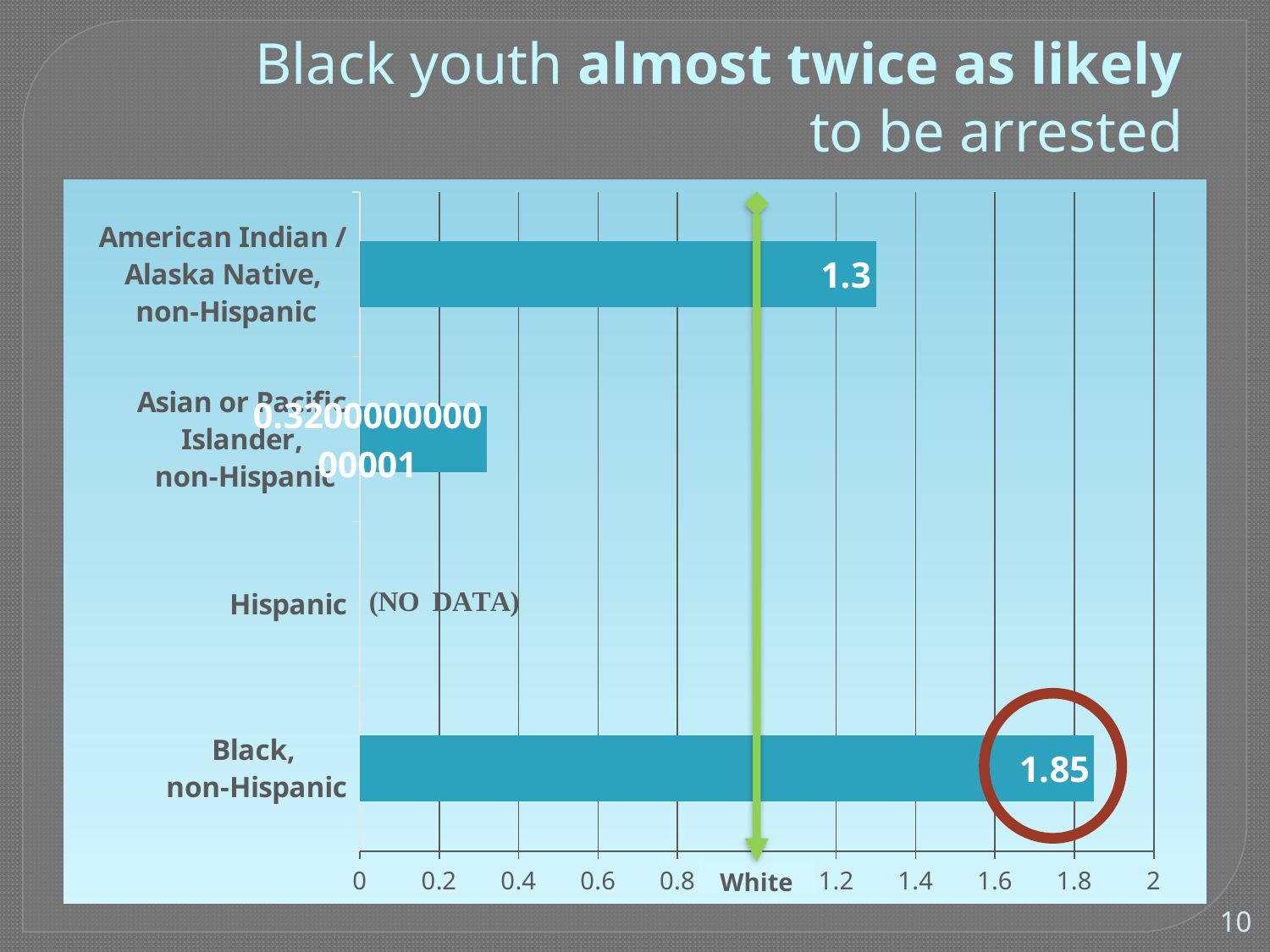
What is the value for American Indian / Alaska Native, non-Hispanic? 1.3 Is the value for American Indian / Alaska Native, non-Hispanic greater or less than 1.2? greater What kind of chart is shown on the slide? bar chart Which category with a plotted bar has the lowest value? Asian or Pacific Islander, non-Hispanic Which category has the highest value? Black, non-Hispanic Is the value for Asian or Pacific Islander, non-Hispanic greater or less than 0.4? less What is the value for Black, non-Hispanic? 1.85 What label is given to the green vertical reference line on the chart? White What is the difference between the values for Black, non-Hispanic and American Indian / Alaska Native, non-Hispanic? 0.55 Which is larger, the value for Black, non-Hispanic or the value for American Indian / Alaska Native, non-Hispanic? Black, non-Hispanic How many categories are listed on the vertical axis? 4 What is shown for the Hispanic category? (NO DATA)